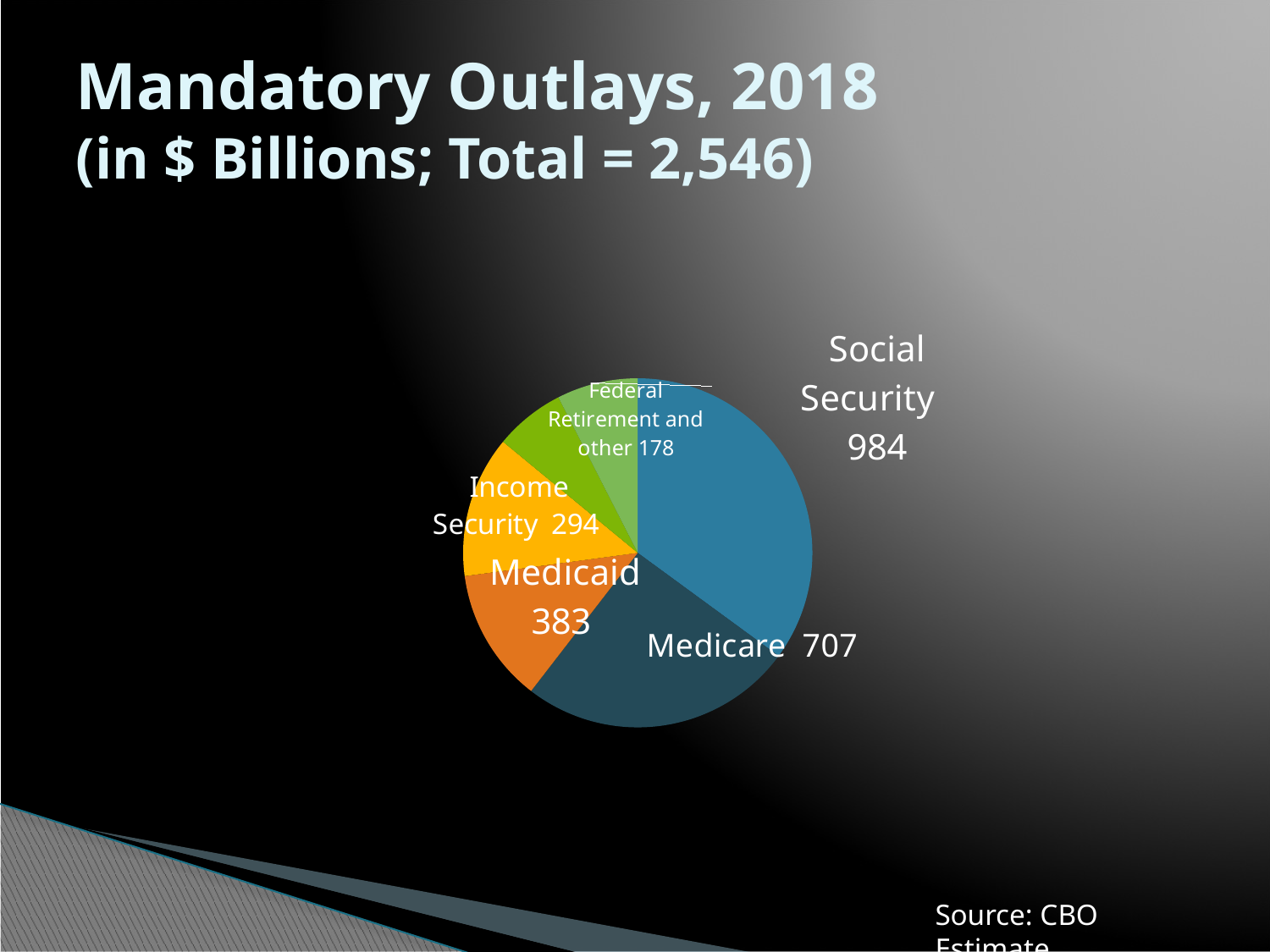
What is the value for Medicare? 707 What is the value for Income Security? 294 What is the value for Federal Retirement and other? 178 Which is larger, Medicare or Medicaid? Medicare What total is stated in the chart title? 2,546 What is the difference between the Medicaid and Income Security values? 89 Which category has the largest slice of the pie? Social Security What is the value for Medicaid? 383 What is the difference between the Social Security and Medicare values? 277 What is the title of the chart? Mandatory Outlays, 2018 (in $ Billions; Total = 2,546) What kind of chart is shown on the slide? pie chart What is the value for Social Security? 984